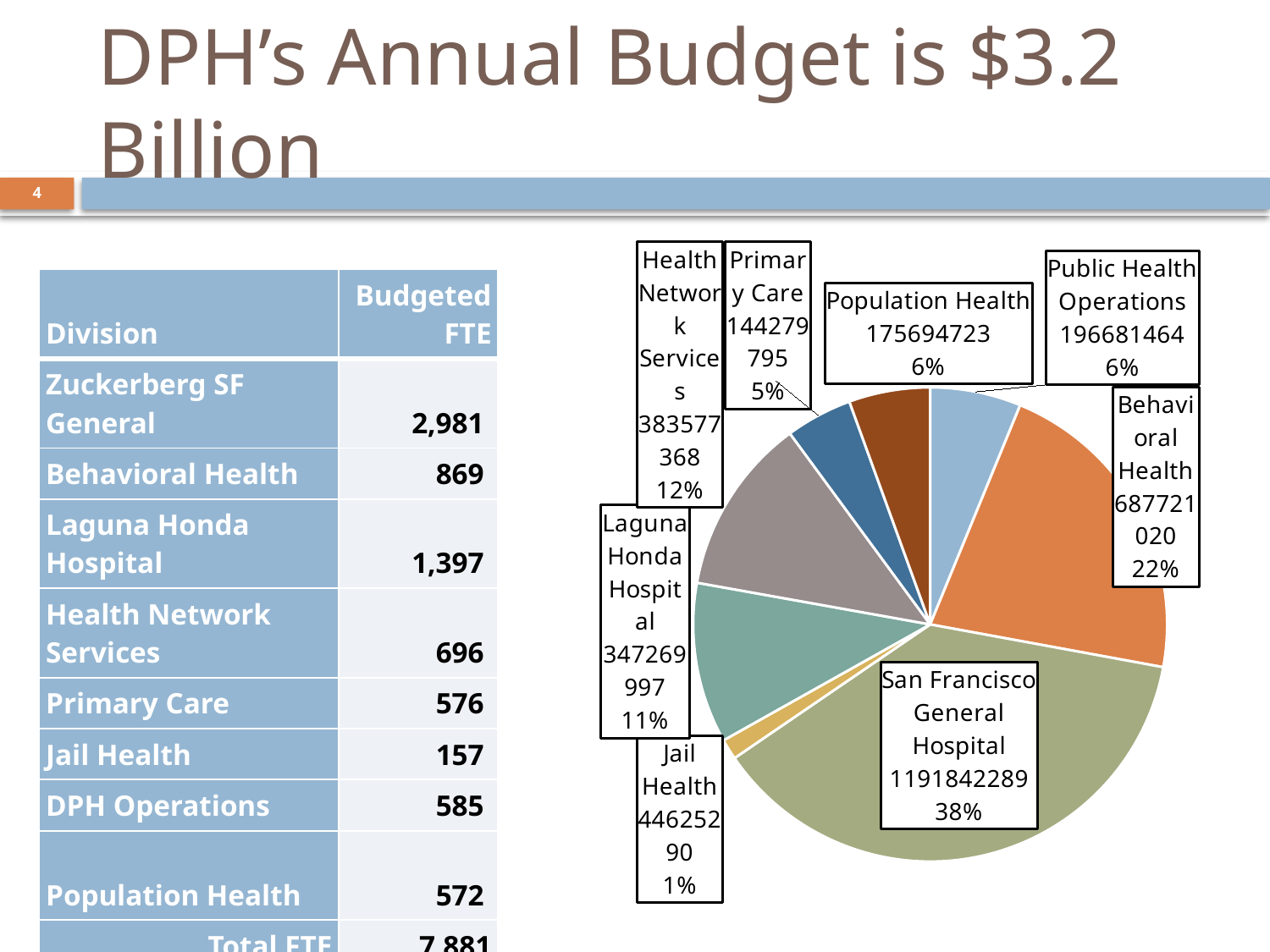
What kind of chart is shown on the slide? pie chart What value is shown for Health Network Services in the pie chart? 383577368 How many slices does the pie chart have? 8 What value is shown for Primary Care in the pie chart? 144279795 What share of the pie does San Francisco General Hospital represent? 38% Which slice of the pie chart is the largest? San Francisco General Hospital Which slice of the pie chart is the smallest? Jail Health What value is shown for Laguna Honda Hospital in the pie chart? 347269997 What share of the pie does Jail Health represent? 1% What share of the pie does Behavioral Health represent? 22% What is the difference in percentage share between Health Network Services and Primary Care in the pie chart? 7% Which is larger in the pie chart, Behavioral Health or Laguna Honda Hospital? Behavioral Health